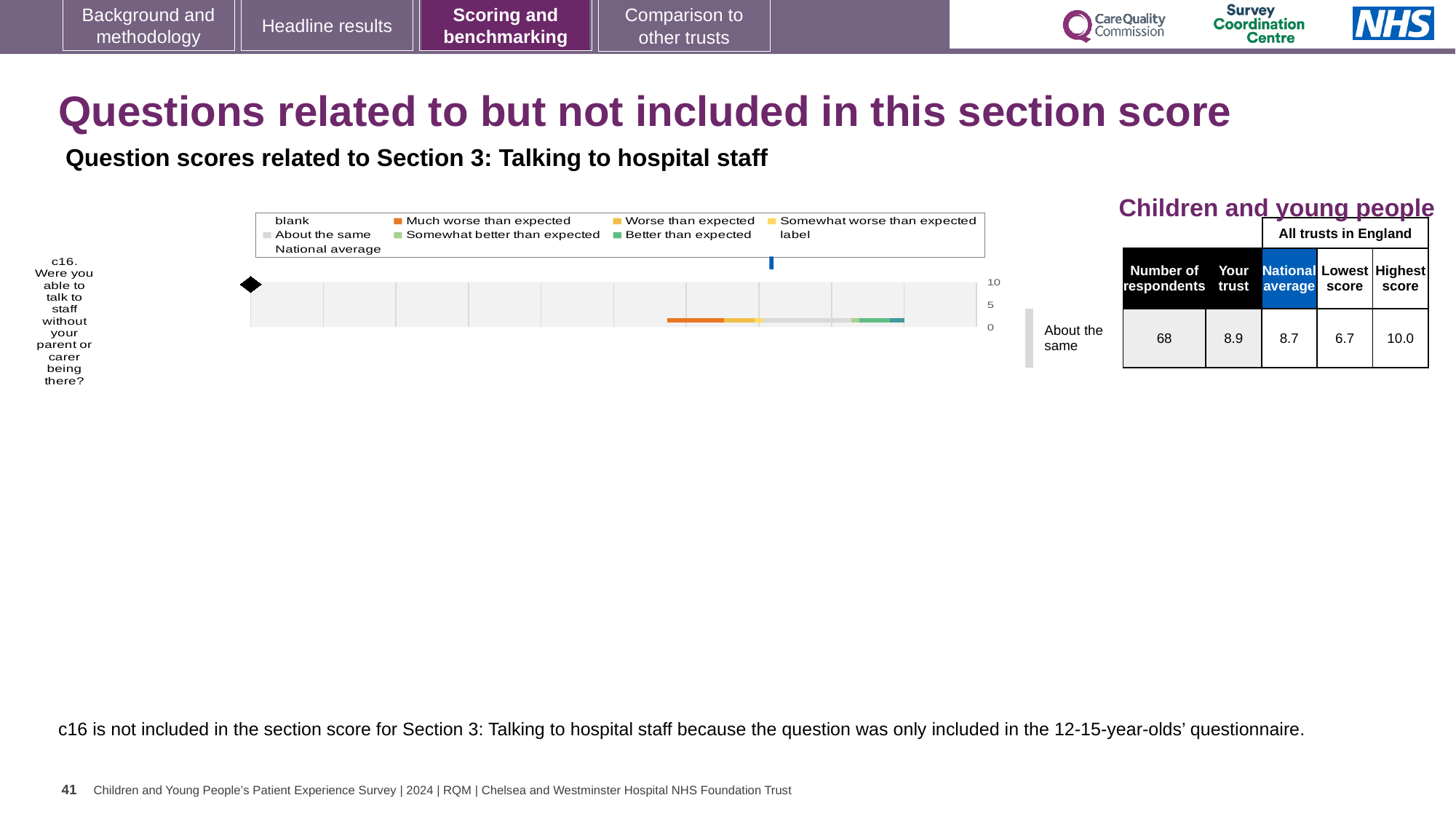
What benchmarking category is c16 placed in? About the same What kind of chart is used to show the c16 benchmarking result? bar chart How many survey questions are plotted on the chart? 1 In the table beside the chart, how many respondents answered c16? 68 What is the highest value shown on the chart's axis? 10 In the table beside the chart, what is the 'Your trust' score for c16? 8.9 Which question number is plotted on the chart? c16 In the table beside the chart, what is the Lowest score among all trusts in England for c16? 6.7 In the table beside the chart, what is the Highest score among all trusts in England for c16? 10.0 For c16, what is the difference between the Highest score and the Lowest score in the table? 3.3 For c16, which is larger: the 'Your trust' score or the National average? Your trust In the table beside the chart, what is the National average score for c16? 8.7